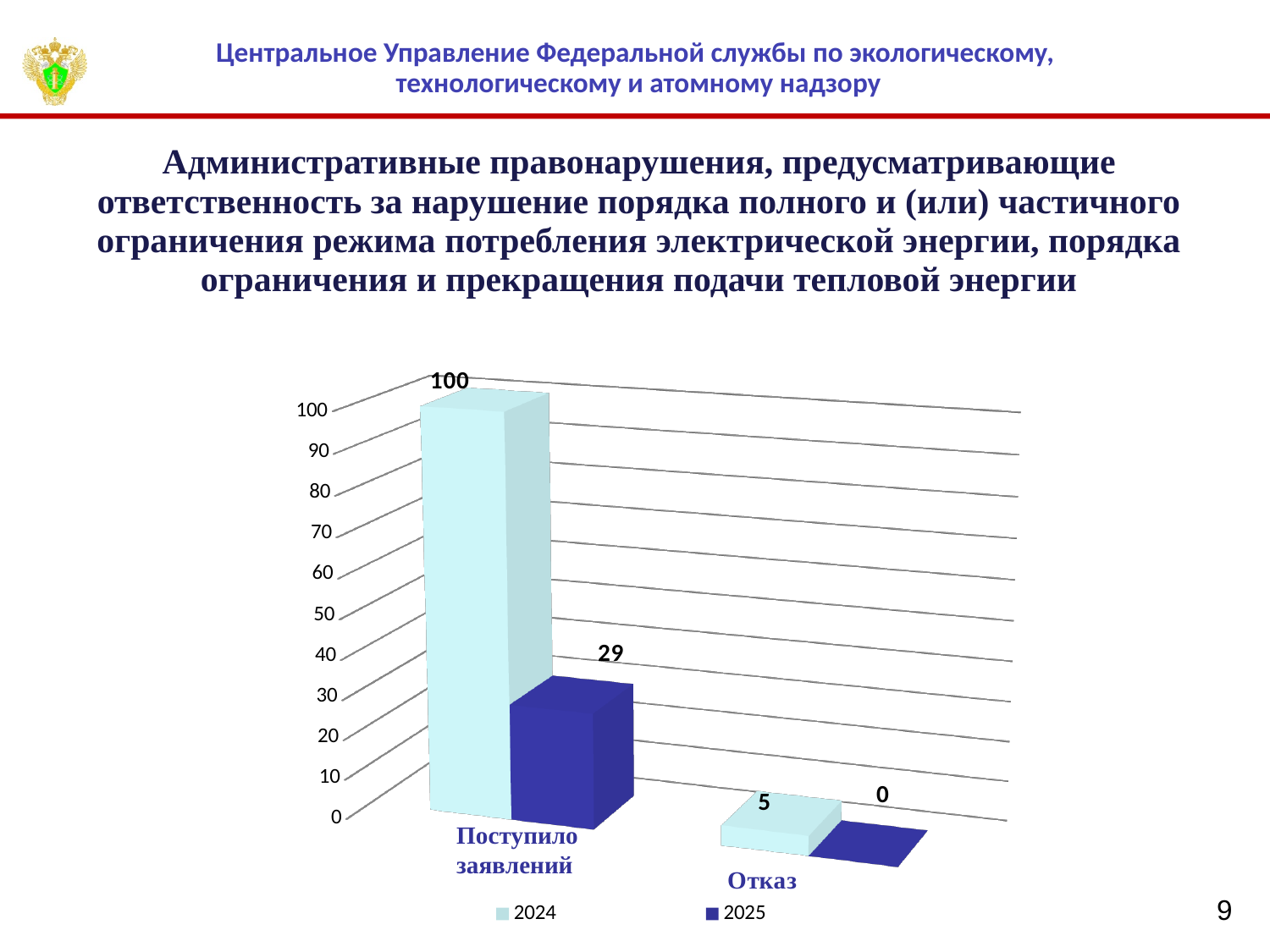
What is the value for 2024 in the 'Отказ' category? 5 What kind of chart is shown on the slide? Bar chart What is the value for 2024 in the 'Поступило заявлений' category? 100 What is the value for 2025 in the 'Поступило заявлений' category? 29 Which series is shown in dark blue according to the legend? 2025 Which category has the lowest value for the 2025 series? Отказ How many categories are shown on the x axis? 2 What is the value for 2025 in the 'Отказ' category? 0 What is the difference between the 2024 and 2025 values for 'Поступило заявлений'? 71 How many series does the legend list? 2 Which category has the highest value for the 2024 series? Поступило заявлений Which is larger for 'Отказ': the 2024 value or the 2025 value? 2024